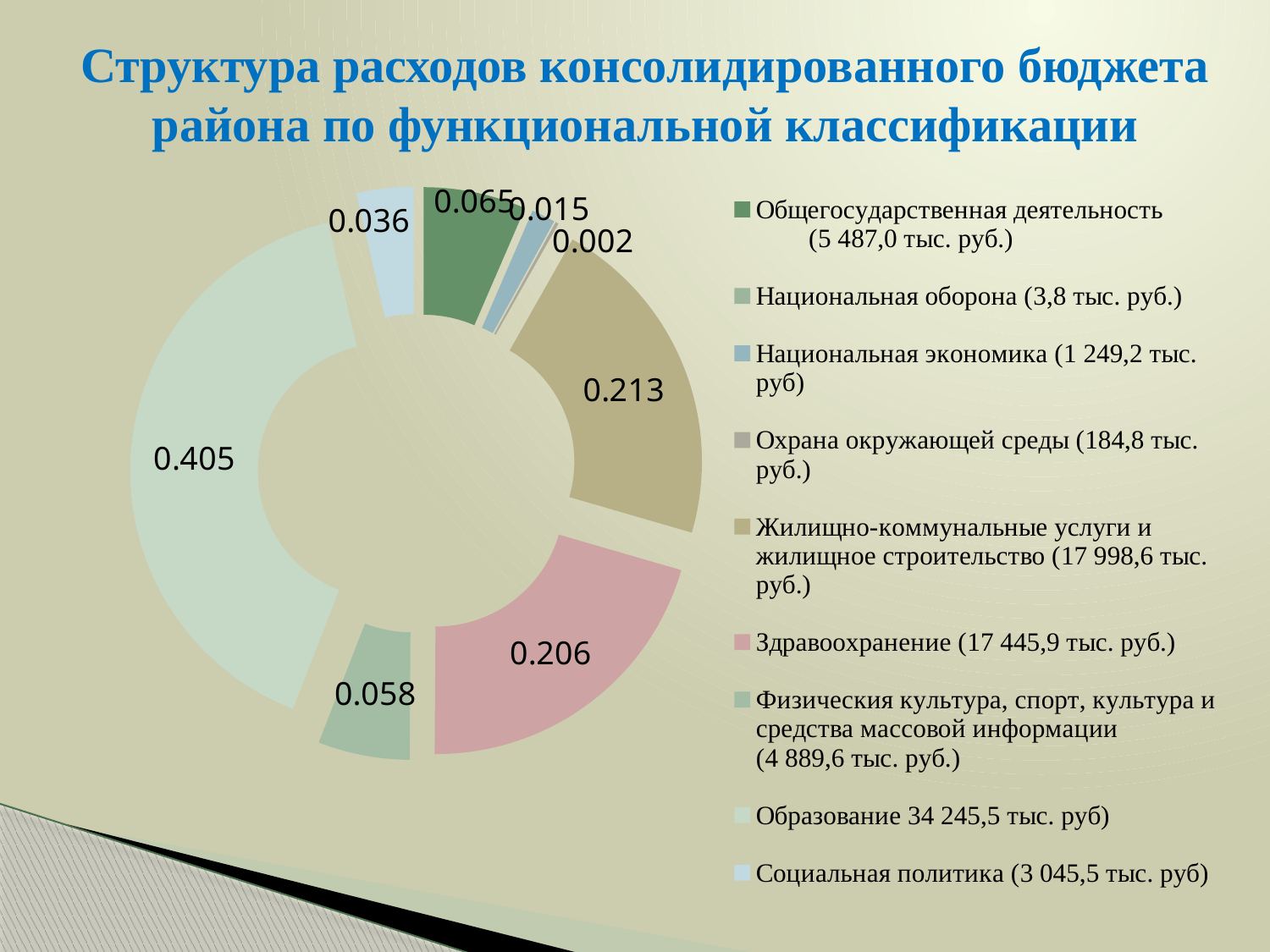
What is the value shown for Общегосударственная деятельность? 0.065 What is the value shown for Жилищно-коммунальные услуги и жилищное строительство? 0.213 How many categories does the legend list? 9 What is the value shown for Здравоохранение? 0.206 Which is larger, the value for Жилищно-коммунальные услуги и жилищное строительство or the value for Здравоохранение? Жилищно-коммунальные услуги и жилищное строительство What is the value shown for Социальная политика? 0.036 According to the legend, what amount in тыс. руб. is given for Образование? 34 245,5 тыс. руб What is the difference between the values for Образование and Жилищно-коммунальные услуги и жилищное строительство? 0.192 What is the difference between the values for Жилищно-коммунальные услуги и жилищное строительство and Здравоохранение? 0.007 What is the value shown for Образование? 0.405 Which category has the largest share of the chart? Образование What kind of chart is shown on the slide? Doughnut (pie) chart